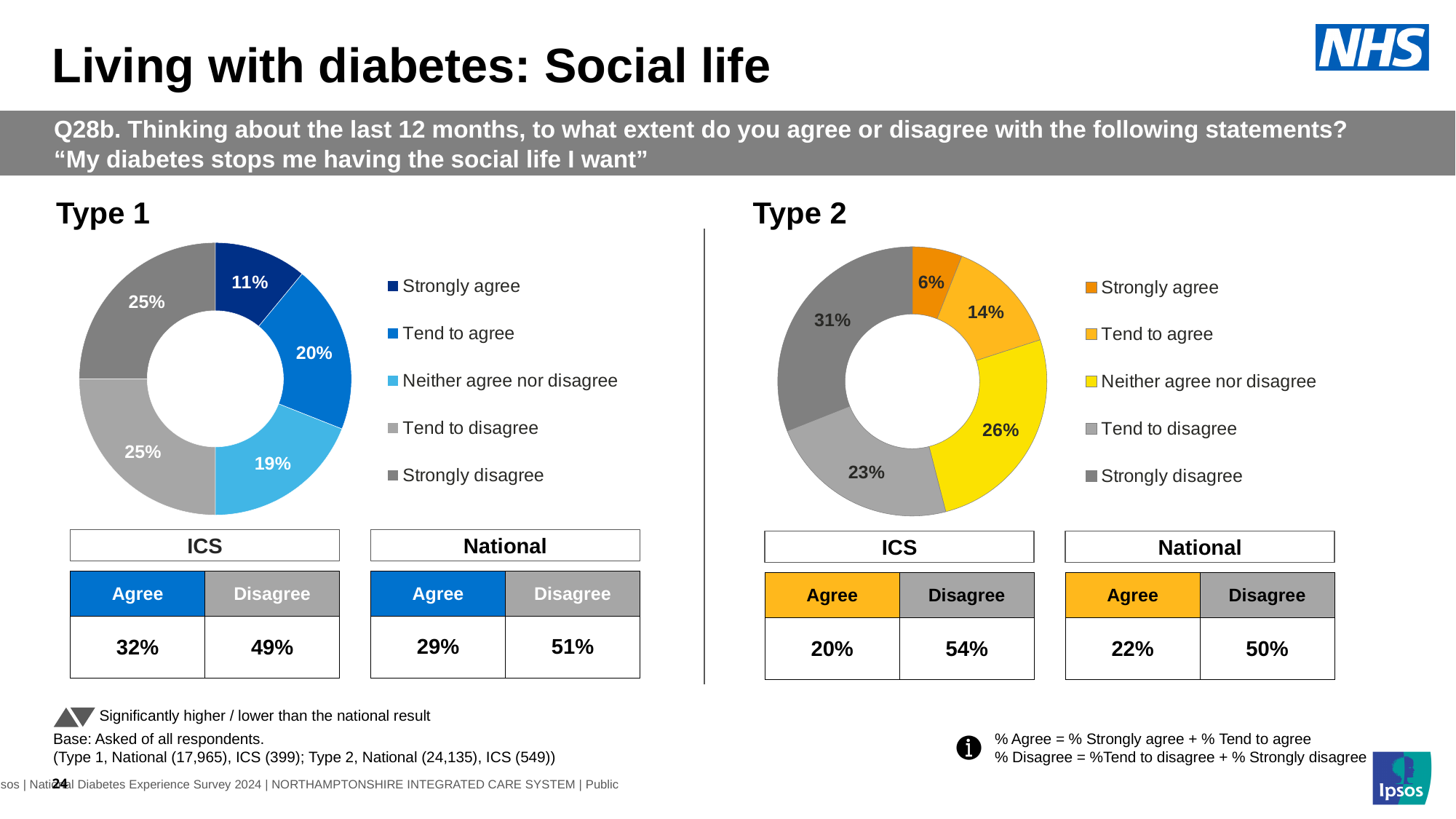
In the Type 2 chart, which category has the smallest share? Strongly agree In the Type 2 chart, which category has the largest share? Strongly disagree In the Type 2 chart, what colour is the Strongly agree segment? Orange What kind of chart is used for Type 1? Doughnut chart In the Type 1 chart, which category has the smallest share? Strongly agree In the Type 1 chart, what is the difference between the Tend to agree and Strongly agree shares? 9 percentage points In the Type 1 chart, what percentage of respondents strongly agree? 11% In the Type 1 chart, what is the combined share of Tend to disagree and Strongly disagree? 50% How many categories does the Type 1 chart's legend list? 5 In the Type 2 chart, what percentage of respondents neither agree nor disagree? 26% In the Type 2 chart, what is the difference between the Strongly disagree and Tend to disagree shares? 8 percentage points In the Type 2 chart, which is larger: Tend to agree or Tend to disagree? Tend to disagree